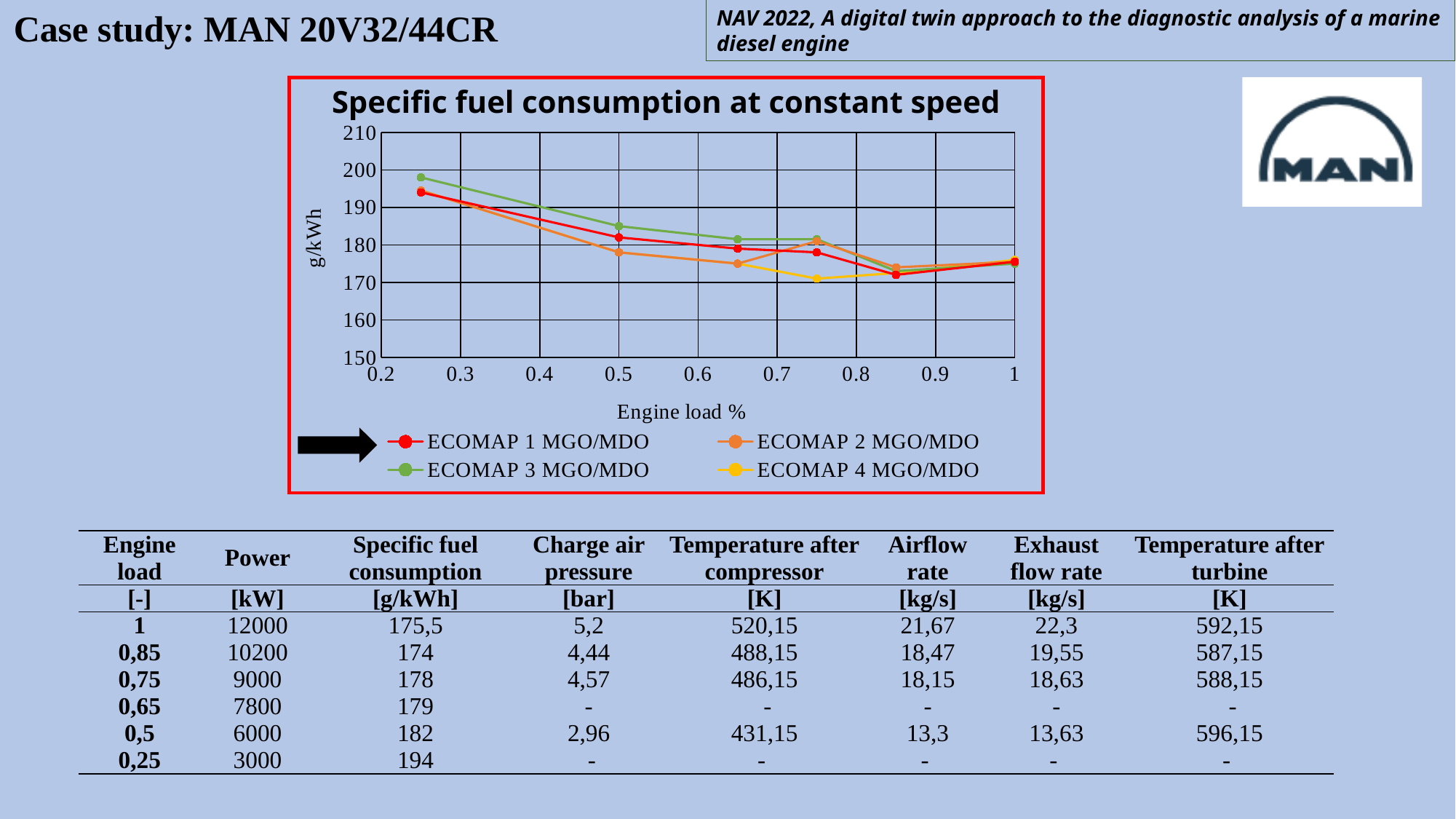
Is the value for ECOMAP 3 MGO/MDO at engine load 0.25 greater or less than 190? greater Is the value for ECOMAP 4 MGO/MDO at engine load 0.75 greater or less than 180? less What is the title of the chart? Specific fuel consumption at constant speed Is the value for ECOMAP 3 MGO/MDO at engine load 0.5 greater or less than 180? greater What is the label of the x axis of the chart? Engine load % At engine load 0.75, which series has the higher value: ECOMAP 2 MGO/MDO or ECOMAP 4 MGO/MDO? ECOMAP 2 MGO/MDO Which series has the lowest value at engine load 0.75? ECOMAP 4 MGO/MDO What kind of chart is shown on the slide? line chart How many series does the legend of the chart list? 4 At engine load 0.25, which series has the higher value: ECOMAP 3 MGO/MDO or ECOMAP 1 MGO/MDO? ECOMAP 3 MGO/MDO Overall, do the specific fuel consumption values rise or fall as engine load increases from 0.25 to 0.85? fall